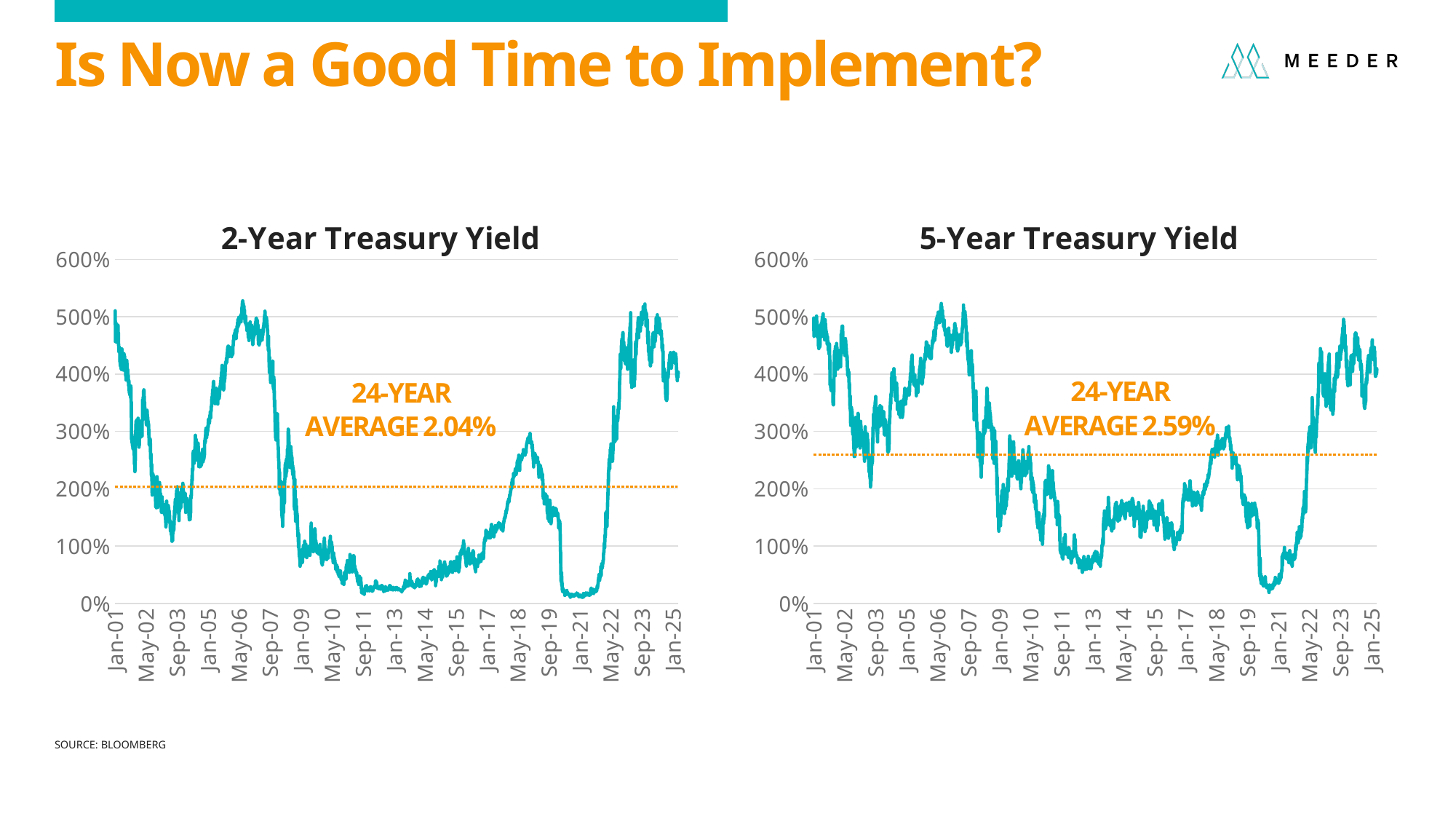
How many charts are shown on the slide? 2 In the 2-Year Treasury Yield chart, is the value around May-06 greater or less than 400%? greater In the 2-Year Treasury Yield chart, does the line rise or fall between Jan-21 and Sep-23? rise In the 5-Year Treasury Yield chart, is the value around Sep-23 greater or less than 300%? greater Which chart shows the higher 24-year average, the 2-Year Treasury Yield or the 5-Year Treasury Yield? 5-Year Treasury Yield In the 5-Year Treasury Yield chart, is the value around Jan-21 greater or less than 100%? less In the 5-Year Treasury Yield chart, what 24-year average is stated? 2.59% What is the difference between the 24-year averages shown on the 5-Year and 2-Year Treasury Yield charts? 0.55% What kind of chart is the 2-Year Treasury Yield chart? line chart What source is cited for the charts on the slide? Bloomberg In the 2-Year Treasury Yield chart, what 24-year average is stated? 2.04%